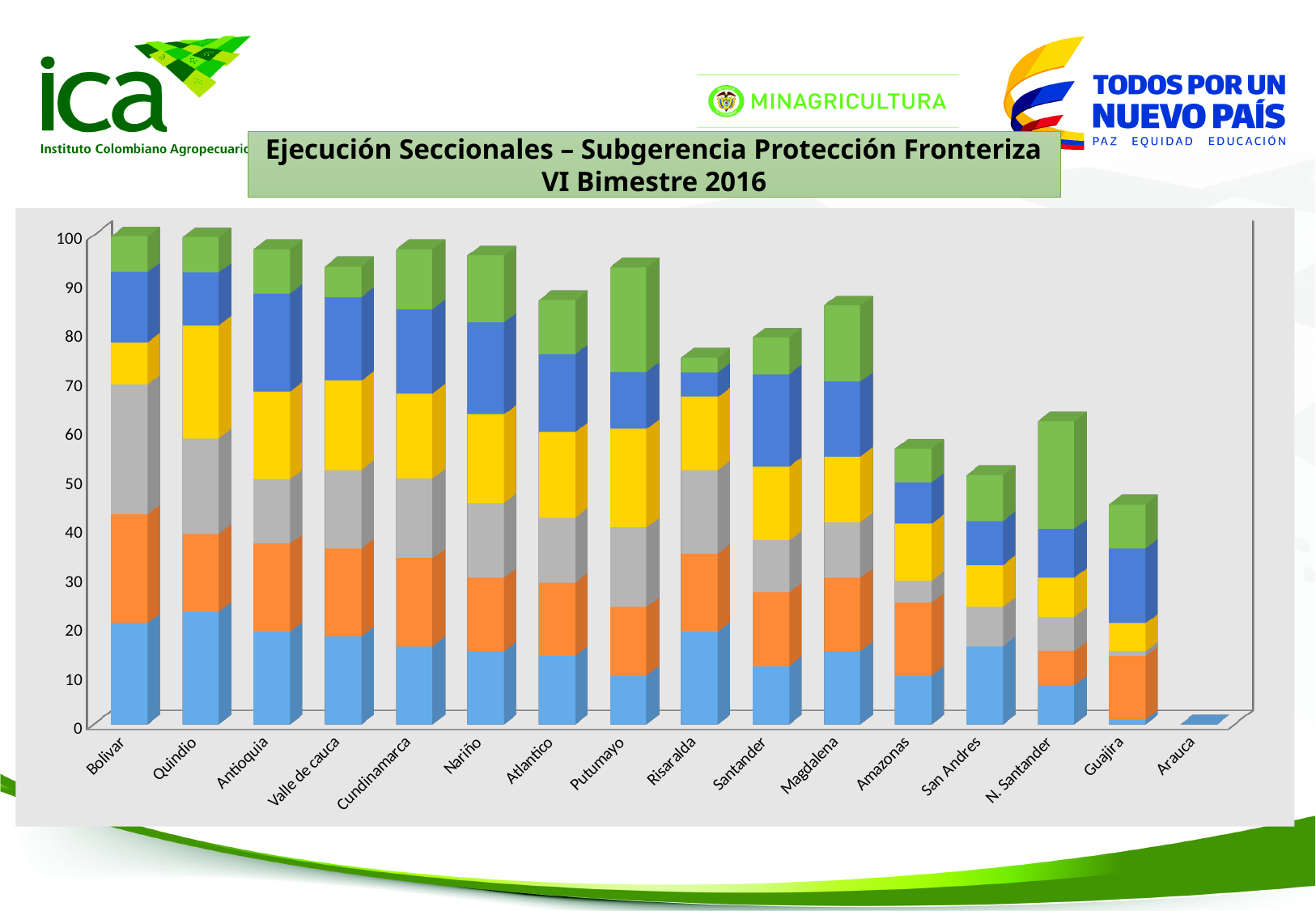
Which has the larger total, Guajira or Amazonas? Amazonas What is the title shown above the chart? Ejecución Seccionales – Subgerencia Protección Fronteriza VI Bimestre 2016 Which category has the lowest total in the chart? Arauca Is the total for Guajira greater or less than 50? less Is the total for Risaralda greater or less than 80? less Is the total for Amazonas greater or less than 50? greater Which has the larger total, Putumayo or Risaralda? Putumayo How many categories (departments) are shown on the x axis of the chart? 16 What kind of chart is shown on the slide? Stacked bar chart Do the bar totals generally rise or fall from left to right along the x axis? Fall